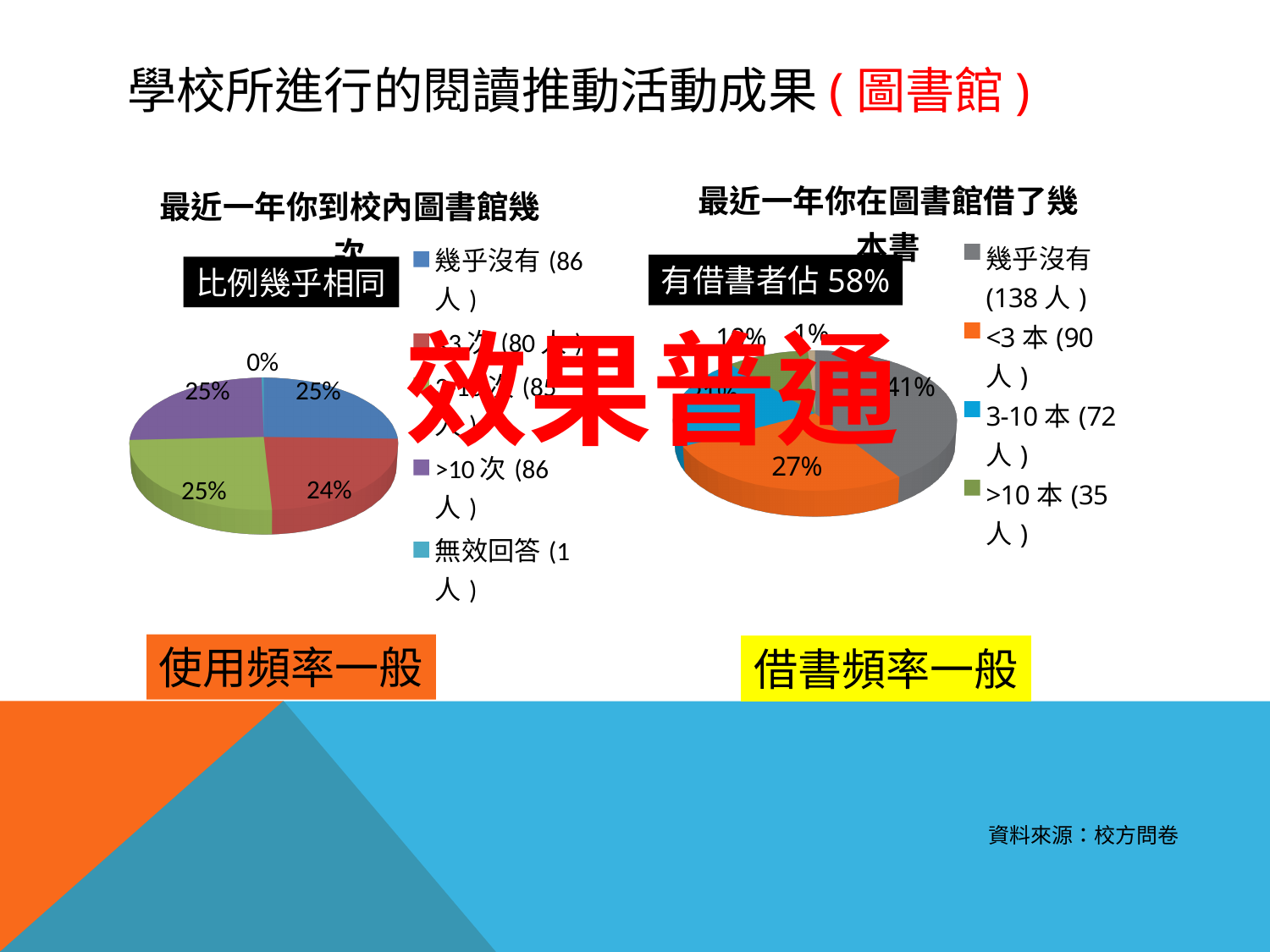
In the left chart (最近一年你到校內圖書館幾次), how many entries does the legend list? 5 What kind of chart is the left chart titled 最近一年你到校內圖書館幾次? pie chart In the right chart (最近一年你在圖書館借了幾本書), what percentage is shown for the 幾乎沒有 slice? 41% In the left chart (最近一年你到校內圖書館幾次), how many people does the legend give for >10次? 86 人 In the left chart (最近一年你到校內圖書館幾次), what percentage is shown for the <3次 slice? 24% In the left chart (最近一年你到校內圖書館幾次), what percentage is shown for the 幾乎沒有 slice? 25% In the right chart (最近一年你在圖書館借了幾本書), what percentage is shown for the <3本 slice? 27% In the right chart (最近一年你在圖書館借了幾本書), which category has the largest share? 幾乎沒有 In the left chart (最近一年你到校內圖書館幾次), which category has the smallest share? 無效回答 In the right chart (最近一年你在圖書館借了幾本書), how many people does the legend give for 幾乎沒有? 138 人 In the right chart (最近一年你在圖書館借了幾本書), what is the difference in percentage points between the 幾乎沒有 slice and the <3本 slice? 14 In the right chart (最近一年你在圖書館借了幾本書), which is larger, the share for 幾乎沒有 or the share for >10本? 幾乎沒有